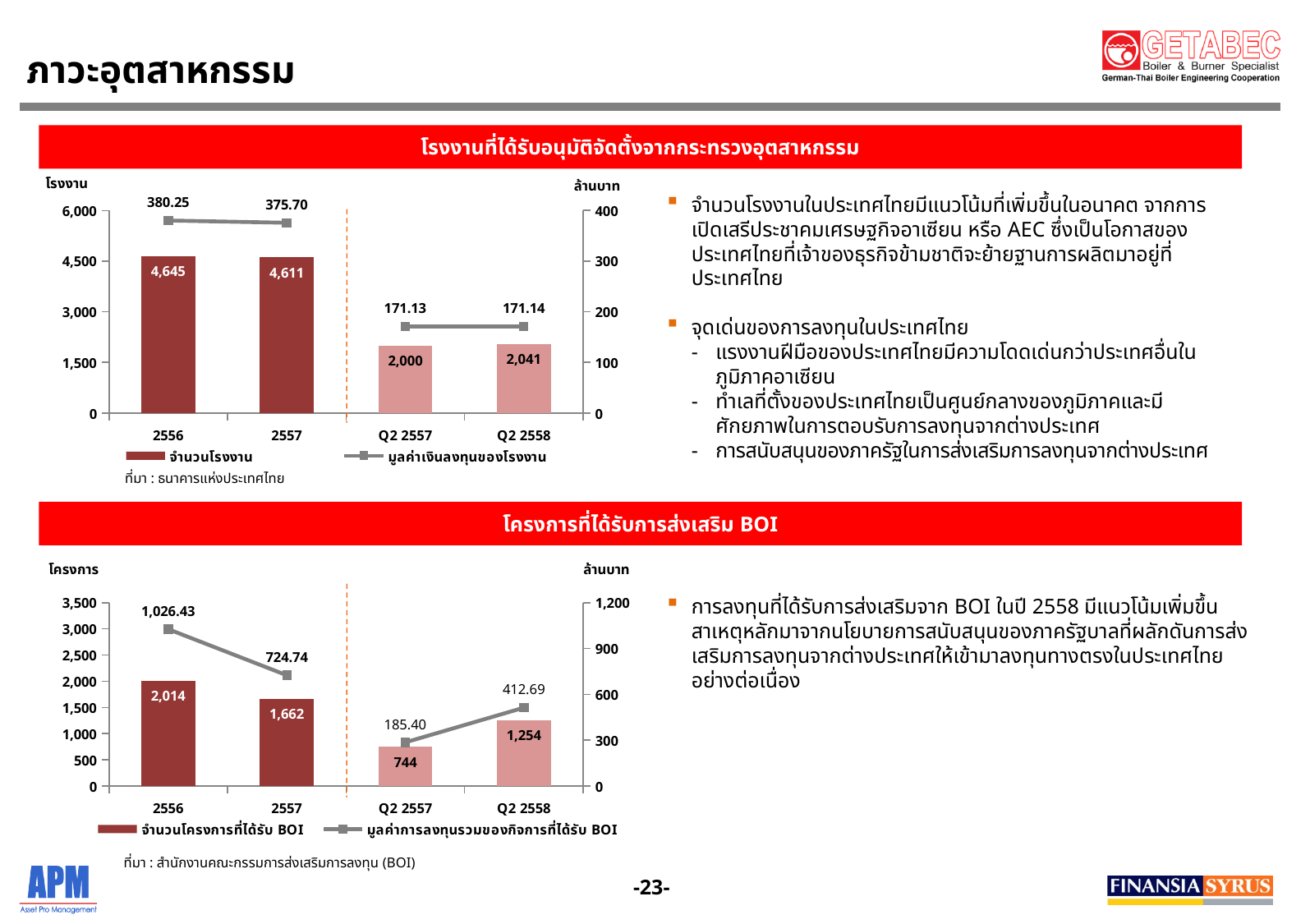
In the bottom chart (โครงการที่ได้รับการส่งเสริม BOI), what is the number of BOI-promoted projects for Q2 2558? 1,254 In the top chart, how many series does the legend list? 2 In the bottom chart, does the investment value rise or fall from 2556 to 2557? fall In the top chart, what is the difference in the number of factories between 2556 and 2557? 34 In the top chart, which category has the highest number of factories? 2556 In the bottom chart, which category has the lowest number of BOI-promoted projects? Q2 2557 In the bottom chart, which is larger: the investment value for Q2 2557 or for Q2 2558? Q2 2558 In the top chart, what is the investment value (มูลค่าเงินลงทุนของโรงงาน) for Q2 2558? 171.14 In the bottom chart, what is the total investment value (มูลค่าการลงทุนรวม) for 2556? 1,026.43 What type of chart is the bottom chart? bar chart with a line In the top chart (โรงงานที่ได้รับอนุมัติจัดตั้งจากกระทรวงอุตสาหกรรม), what is the number of factories (จำนวนโรงงาน) for 2556? 4,645 In the top chart, how many categories are shown on the x axis? 4